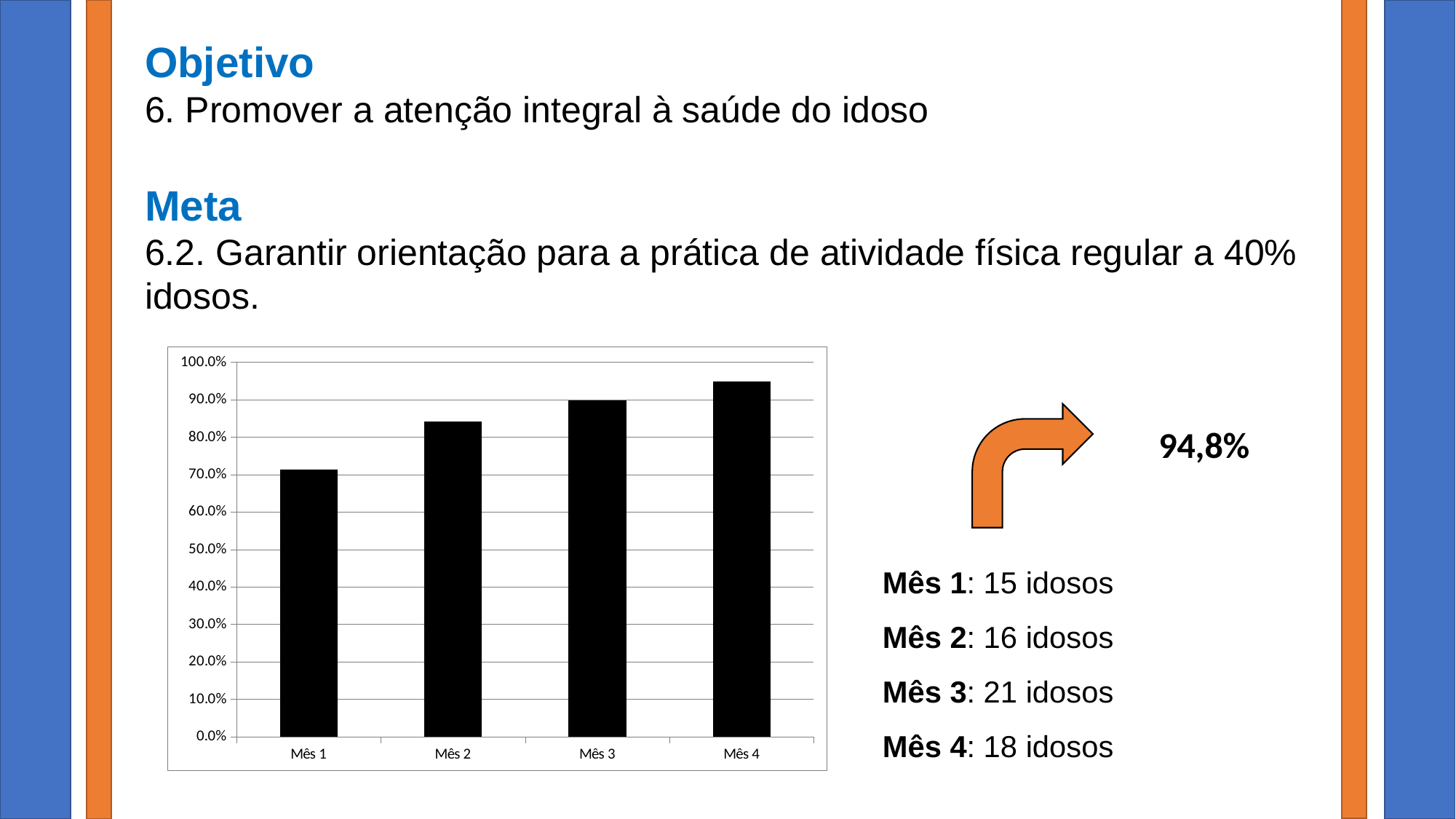
Is the value for Mês 2 greater or less than 80.0%? greater Do the bar values rise or fall from Mês 1 to Mês 4? rise Is the value for Mês 3 greater or less than 80.0%? greater How many categories are plotted on the x axis of the chart? 4 What kind of chart is shown on the slide? bar chart Is the value for Mês 4 greater or less than 90.0%? greater What colour are the bars in the chart? black What is the highest tick label shown on the y axis of the chart? 100.0% Which month has the lowest bar in the chart? Mês 1 Which is larger, the value for Mês 2 or the value for Mês 3? Mês 3 Which month has the highest bar in the chart? Mês 4